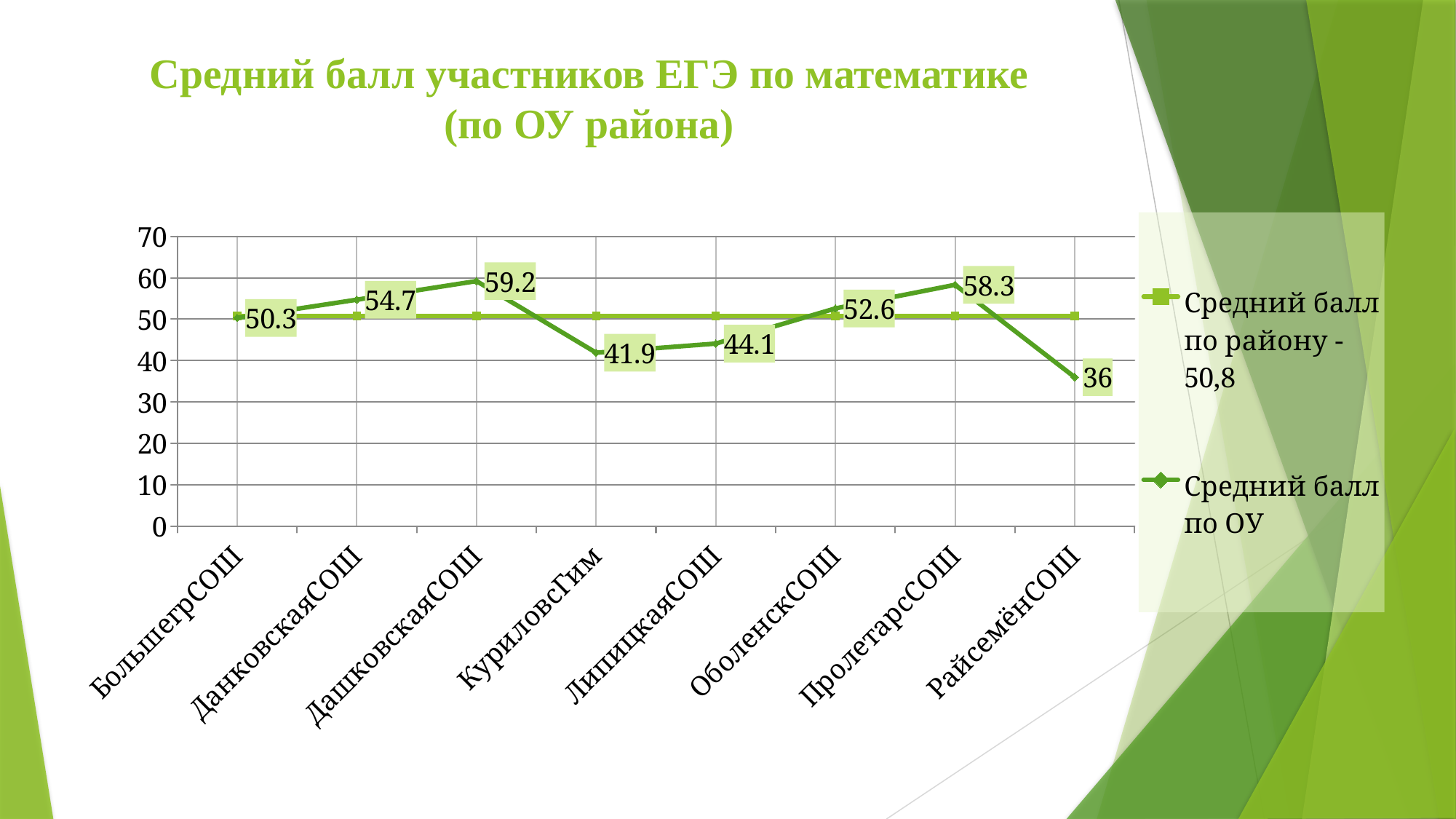
How many schools are shown on the x axis? 8 What is the average score for ДашковскаяСОШ? 59.2 Is the average score for ЛипицкаяСОШ greater or less than 50? less What district average value is given in the legend entry 'Средний балл по району'? 50,8 What is the average score for РайсемёнСОШ? 36 Which has a higher average score, ДанковскаяСОШ or ОболенскСОШ? ДанковскаяСОШ Which school has the highest average score? ДашковскаяСОШ How many series does the legend list? 2 What is the difference between the average scores of ДашковскаяСОШ and РайсемёнСОШ? 23.2 Which school has the lowest average score? РайсемёнСОШ What type of chart is shown on the slide? line chart What is the average score for КуриловсГим? 41.9